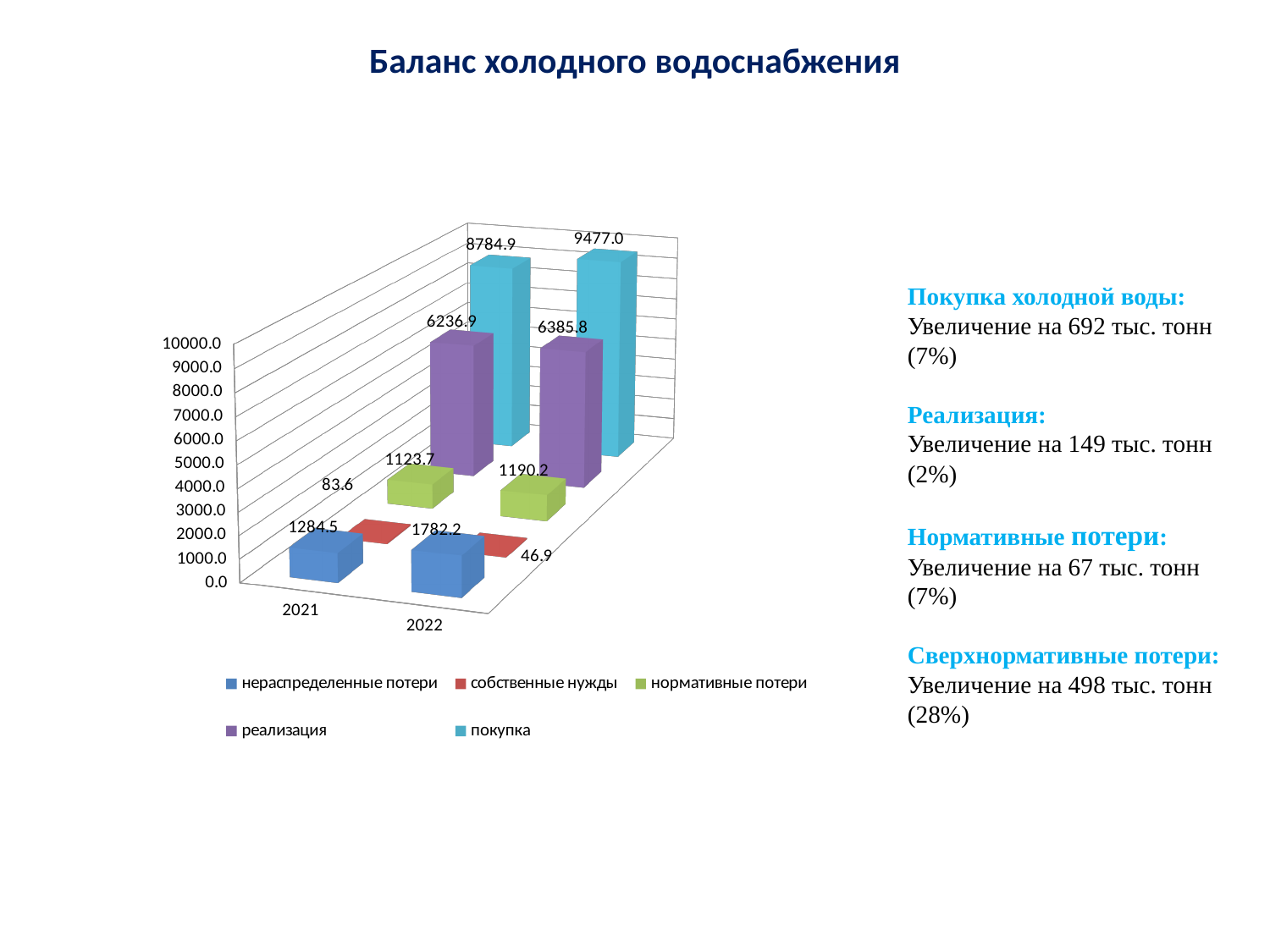
Which series has the highest value in 2022? покупка What is the value of реализация for 2021? 6236.9 What is the difference between the покупка values for 2022 and 2021? 692.1 What is the value of нераспределенные потери for 2022? 1782.2 What is the value of собственные нужды for 2021? 83.6 How many series does the legend list? 5 What is the title of the slide's chart? Баланс холодного водоснабжения Which series has the lowest value in 2021? собственные нужды What type of chart is shown on the slide? bar chart Which is larger: нераспределенные потери in 2021 or in 2022? 2022 What is the value of нормативные потери for 2022? 1190.2 What is the value of покупка for 2022? 9477.0